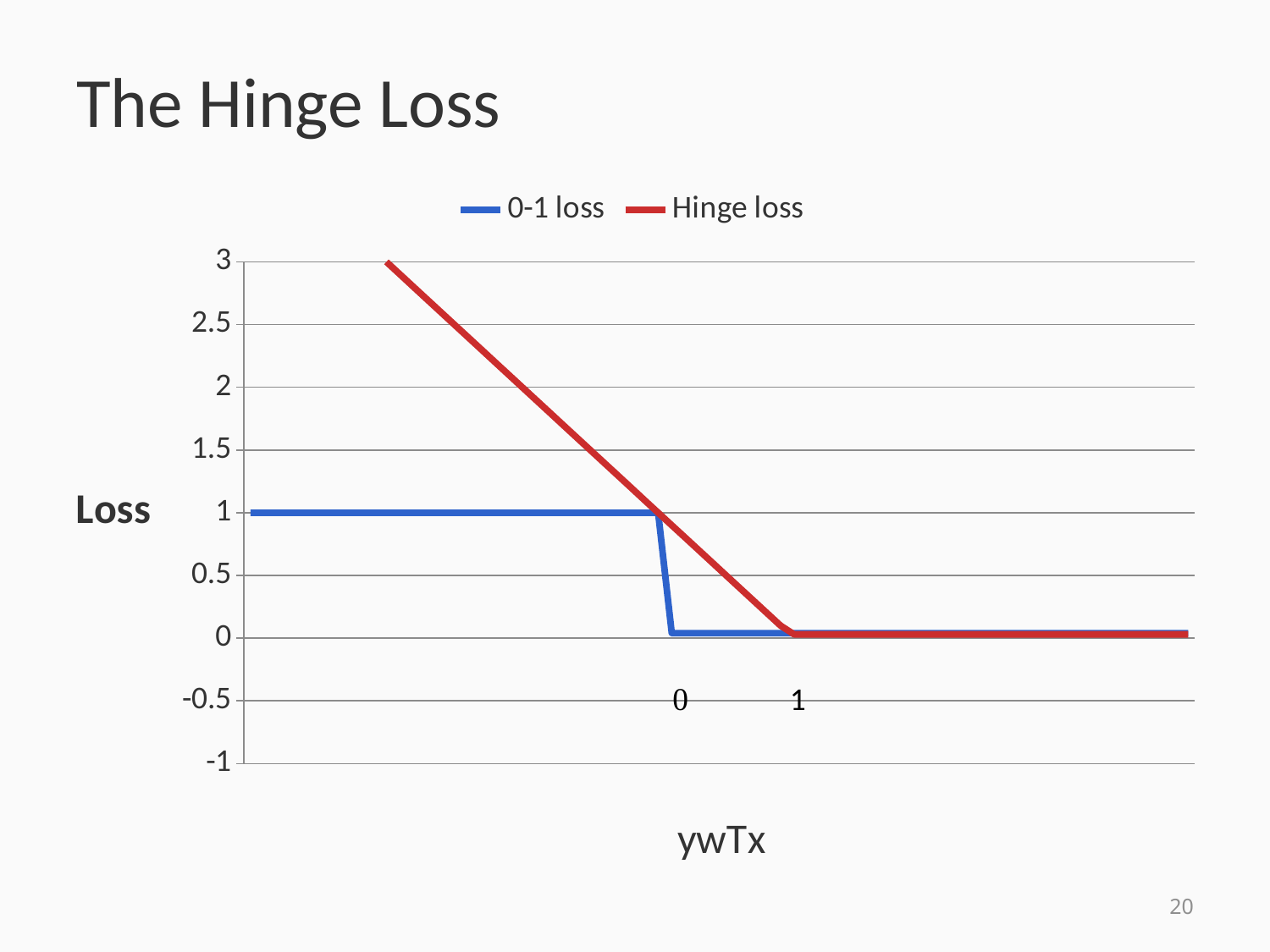
What is the value of the 0-1 loss for ywTx values to the left of 0? 1 How many series does the legend list? 2 What is the highest value shown on the Loss axis? 3 What are the two series named in the legend? 0-1 loss and Hinge loss Between ywTx = 0 and ywTx = 1, which series has the larger loss value, 0-1 loss or Hinge loss? Hinge loss What is the value of the Hinge loss at ywTx = 0? 1 What kind of chart is shown on the slide? Line chart Does the Hinge loss rise or fall as ywTx increases from the left edge of the chart to 1? Falls What colour is the Hinge loss line? Red What is the value of the Hinge loss at ywTx = 1? 0 What is the value of the 0-1 loss at ywTx = 1? 0 Is the Hinge loss at the left end of the red line greater or less than 2.5? greater